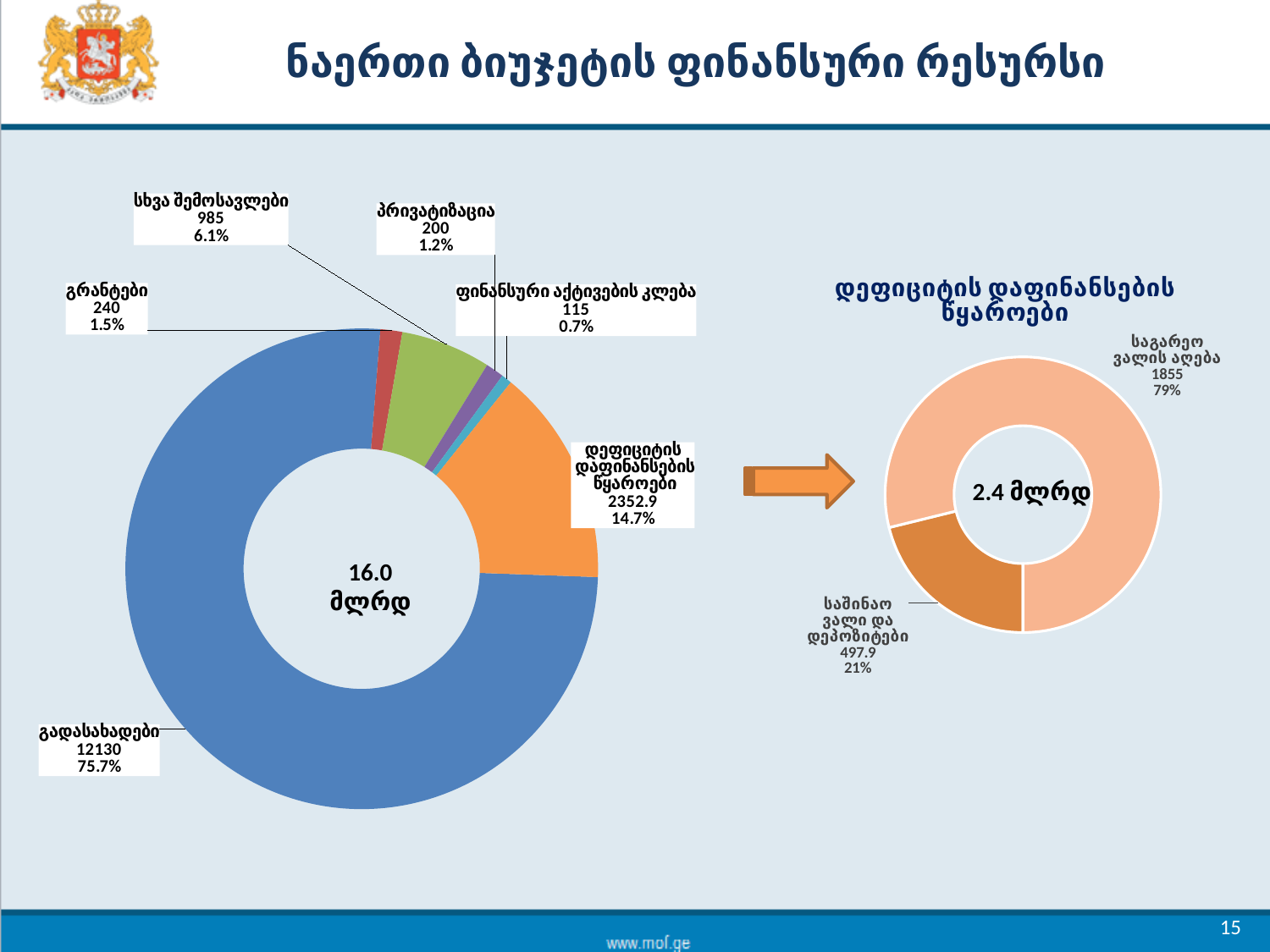
In the left donut chart, which category has the largest value? გადასახადები In the left donut chart, which category has the smallest value? ფინანსური აქტივების კლება How many categories are shown in the left donut chart? 6 In the left donut chart, what is the difference between the values for გრანტები and პრივატიზაცია? 40 In the left donut chart, what percentage share is shown for სხვა შემოსავლები? 6.1% In the chart titled დეფიციტის დაფინანსების წყაროები, what percentage share does საშინაო ვალი და დეპოზიტები have? 21% What kind of chart is the chart titled დეფიციტის დაფინანსების წყაროები? Donut (pie) chart In the left donut chart, what value is shown for გადასახადები? 12130 What total is printed in the centre of the left donut chart? 16.0 მლრდ In the left donut chart, what value is shown for დეფიციტის დაფინანსების წყაროები? 2352.9 In the chart titled დეფიციტის დაფინანსების წყაროები, what value is shown for საგარეო ვალის აღება? 1855 In the left donut chart, which is larger: სხვა შემოსავლები or გრანტები? სხვა შემოსავლები